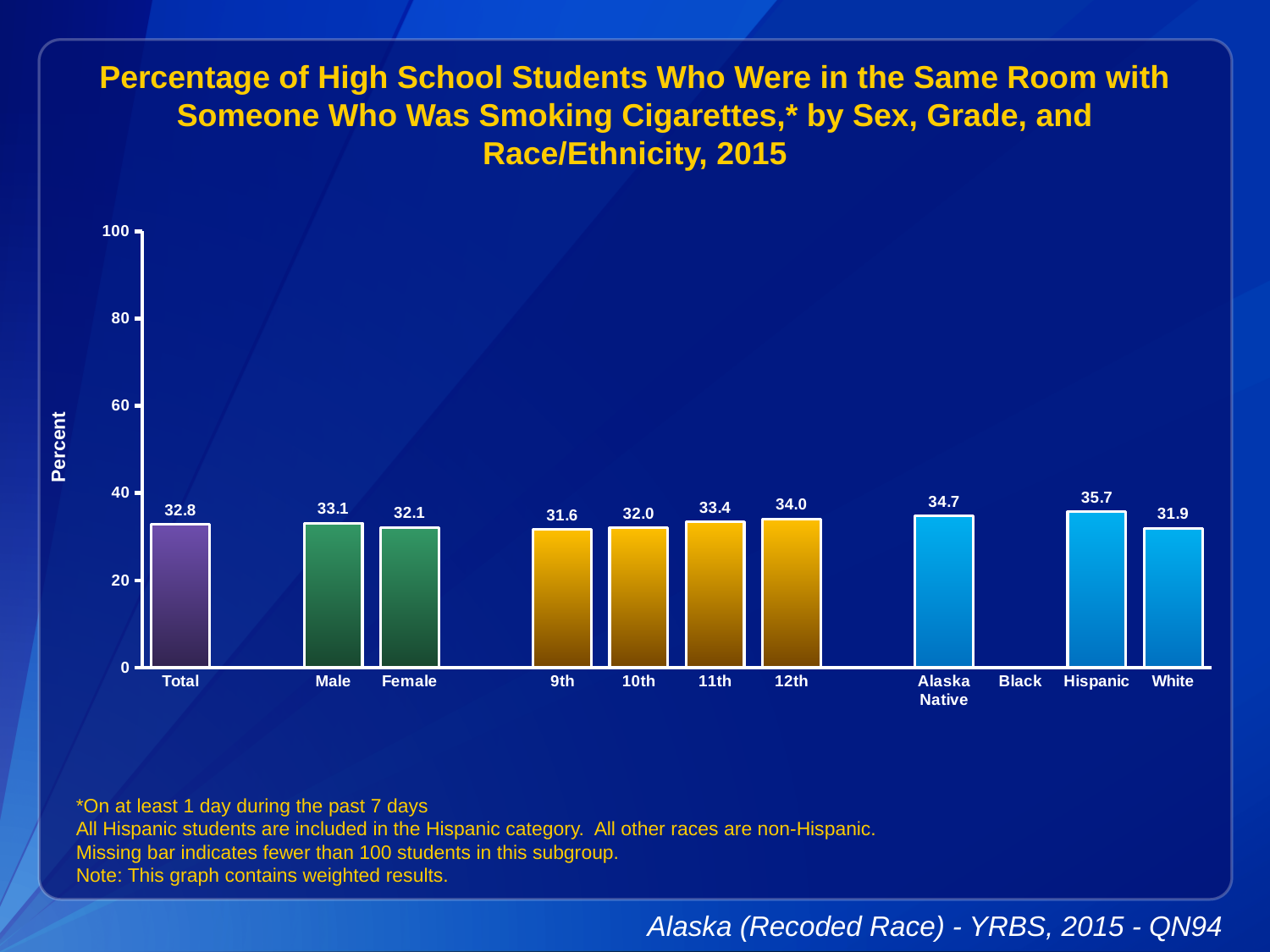
Is the value for White greater or less than 40? less What is the value for 12th grade? 34.0 What is the value for Total? 32.8 What is the value for Alaska Native? 34.7 Which category label has no bar plotted? Black What is the value for Female? 32.1 What is the difference between the Male and Female values? 1.0 Which is larger, the value for 11th grade or the value for 10th grade? 11th Which category has the highest value? Hispanic What kind of chart is shown? bar chart Which category has the lowest value? 9th How many bars are plotted on the chart? 10